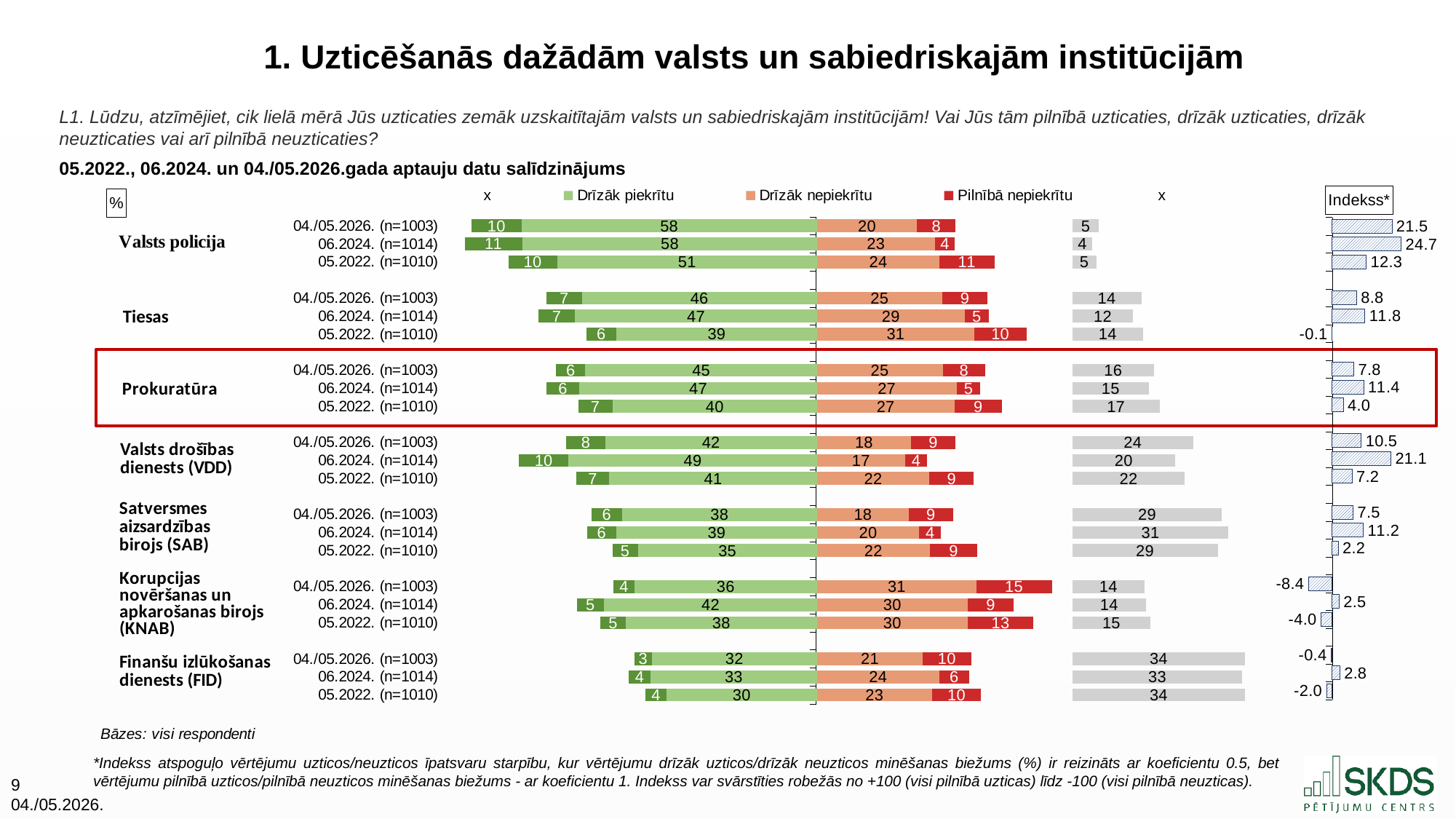
Which institution and survey wave has the highest Indekss* value on the chart? Valsts policija, 06.2024 (24.7) Which has a higher Indekss* value in 04./05.2026: Tiesas or Prokuratūra? Tiesas (8.8 vs 7.8) What percentage answered "Pilnībā nepiekrītu" for Korupcijas novēršanas un apkarošanas birojs (KNAB) in 04./05.2026? 15 How many institutions are listed on the chart? 7 What type of chart is used to show the survey responses? Stacked horizontal bar chart Which institution and survey wave has the lowest Indekss* value on the chart? Korupcijas novēršanas un apkarošanas birojs (KNAB), 04./05.2026 (-8.4) How did the Indekss* value for Finanšu izlūkošanas dienests (FID) change from 06.2024 to 04./05.2026? It fell from 2.8 to -0.4 What is the Indekss* value for Prokuratūra in the 06.2024 survey? 11.4 What is the difference between the Indekss* values of Valsts policija in 06.2024 and 04./05.2026? 3.2 By how many percentage points did the "Drīzāk piekrītu" share for Valsts drošības dienests (VDD) change from 06.2024 to 04./05.2026? 7 (49 to 42) What percentage of respondents answered "Drīzāk piekrītu" for Valsts policija in the 04./05.2026 survey? 58 Which three survey waves are compared on the chart? 05.2022., 06.2024. and 04./05.2026.